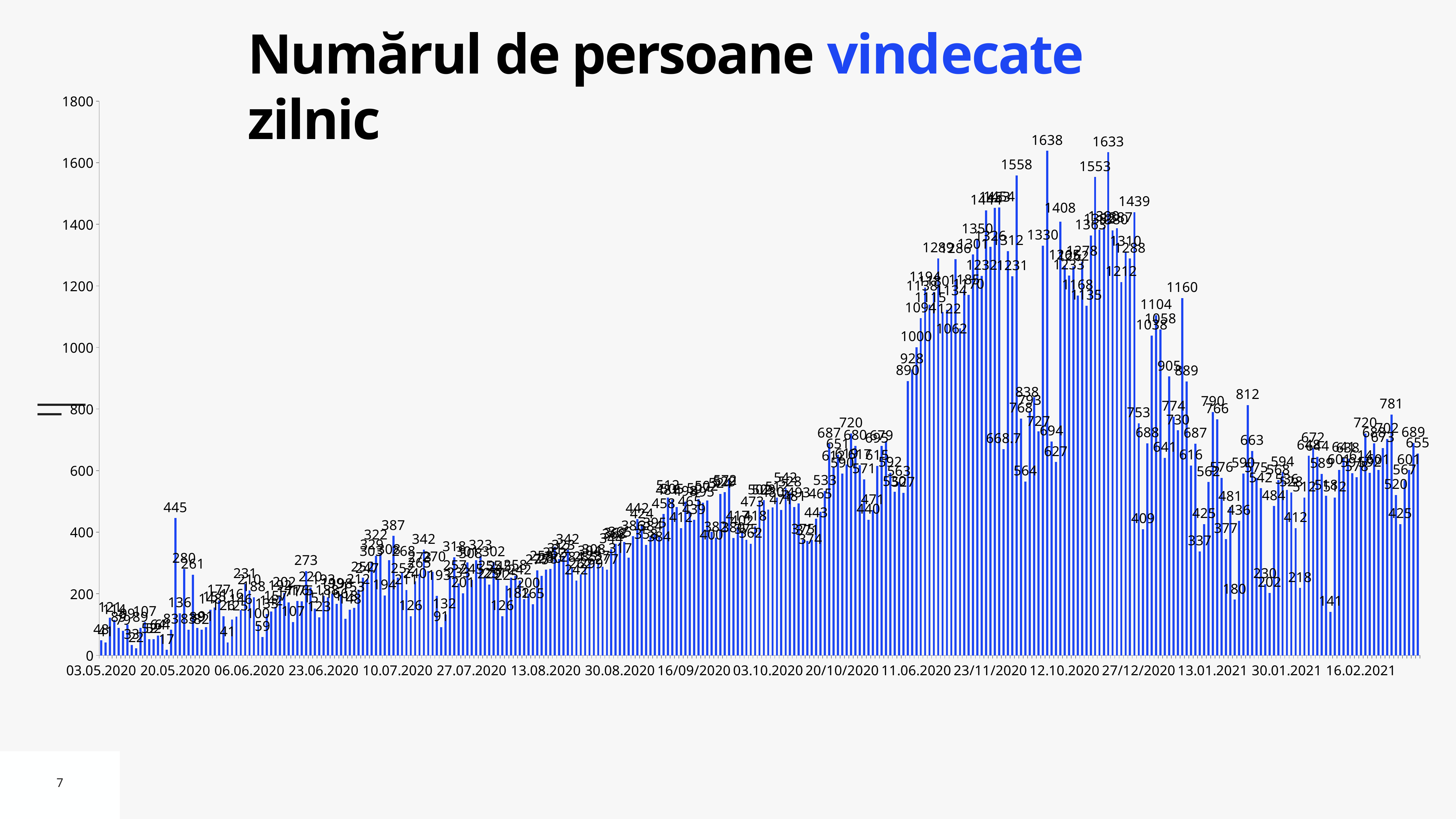
Overall, do the daily values rise or fall from May 2020 to the end of 2020? rise What is the difference between the two highest labeled values, 1638 and 1633? 5 Is the value of the tallest bar greater or less than 1600? greater What is the value of the tallest bar in May 2020, labeled near 20.05.2020? 445 What kind of chart is shown on the slide? bar chart What is the highest daily value labeled on the chart? 1638 What is the highest tick value shown on the vertical axis? 1800 What is the title of the chart on the slide? Numărul de persoane vindecate zilnic Is the value of the last bar on the right of the chart greater or less than 800? less Which labeled value is larger, 1558 or 1553? 1558 What is the difference between the labeled values 1558 and 1553? 5 Is the value of the first bar (03.05.2020) greater or less than 200? less